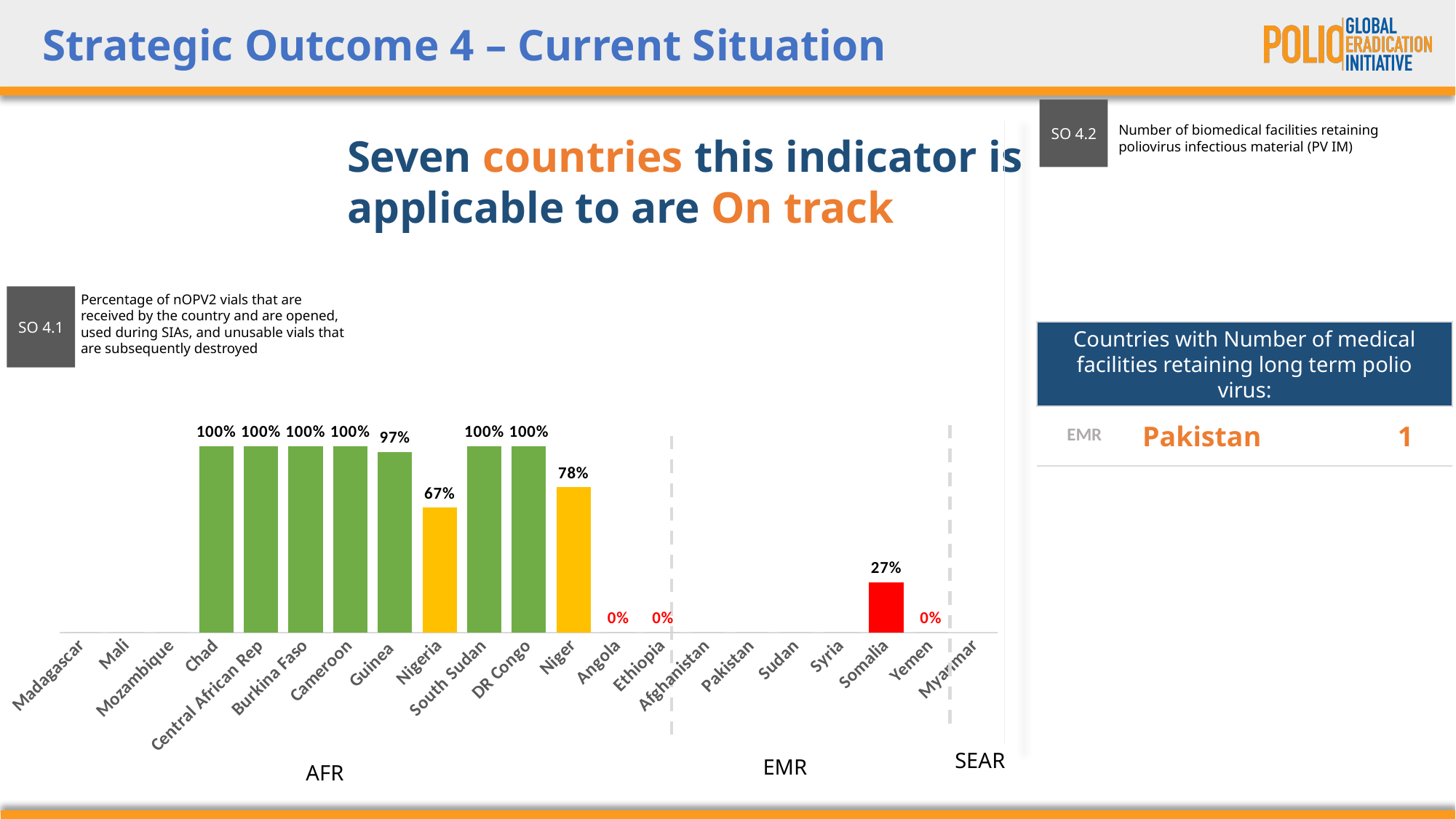
What is the value shown for Nigeria? 67% Which has a higher value, Somalia or Nigeria? Nigeria What is the value shown for Angola? 0% What is the difference between the values for Guinea and Nigeria? 30% What is the value shown for Somalia? 27% What colour is the bar for Somalia? Red What is the value shown for Niger? 78% What is the value shown for Guinea? 97% Which has a higher value, Guinea or Niger? Guinea What kind of chart is shown on the slide? Bar chart How many countries are listed on the x axis of the chart? 21 What is the difference between the values for Niger and Nigeria? 11%